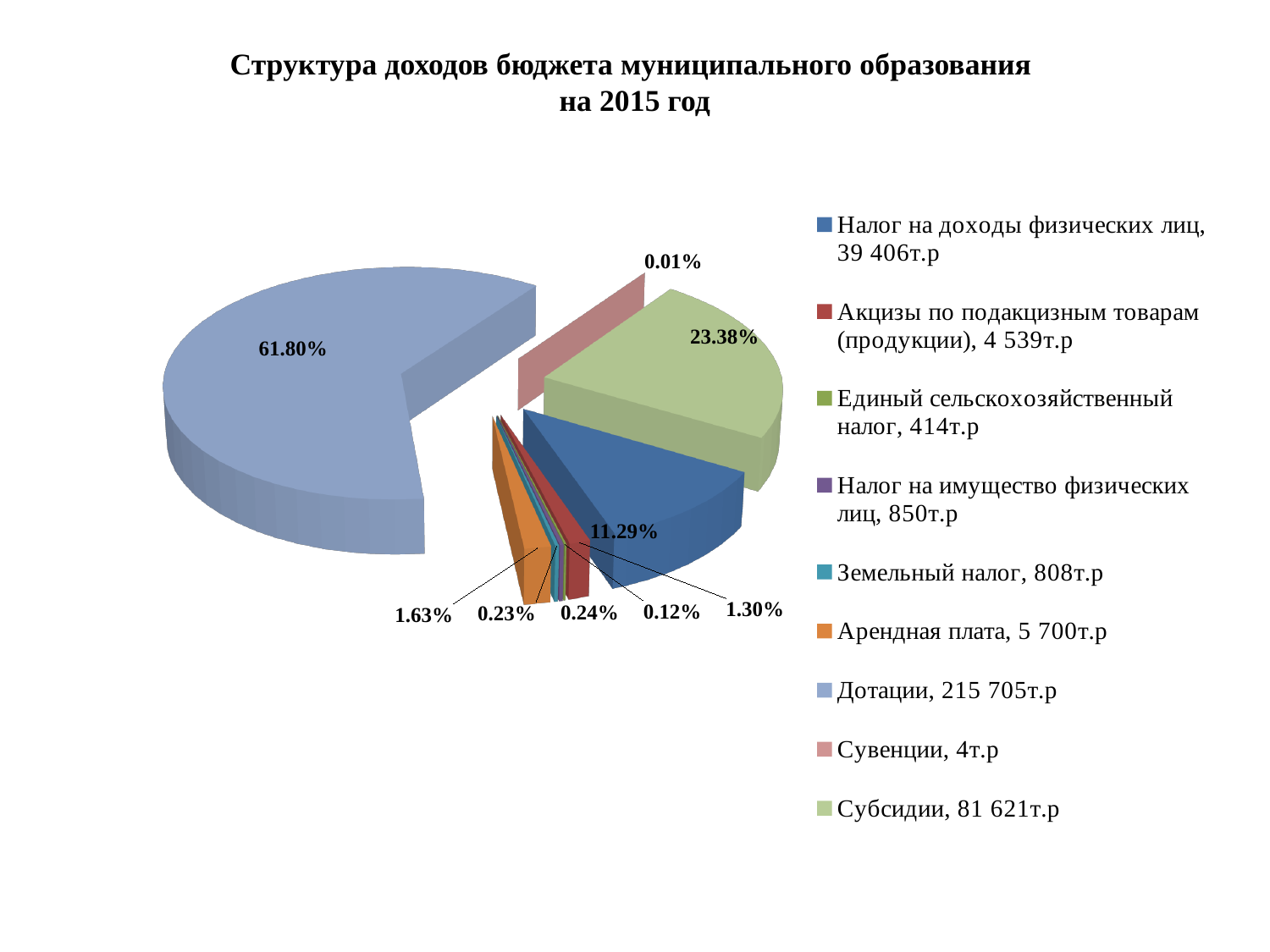
What is the title of the chart? Структура доходов бюджета муниципального образования на 2015 год What share of the pie does Дотации account for? 61.80% What share of the pie does Субсидии account for? 23.38% What value is given in the legend for Субсидии? 81 621т.р What value is given in the legend for Арендная плата? 5 700т.р What is the difference in percentage points between the Дотации slice and the Субсидии slice? 38.42% What share of the pie does Налог на доходы физических лиц account for? 11.29% Which category has the largest slice of the pie? Дотации Which category has the smallest slice of the pie? Сувенции How many categories does the legend of the pie chart list? 9 What kind of chart is shown on the slide? pie chart Which is larger, the slice for Субсидии or the slice for Налог на доходы физических лиц? Субсидии